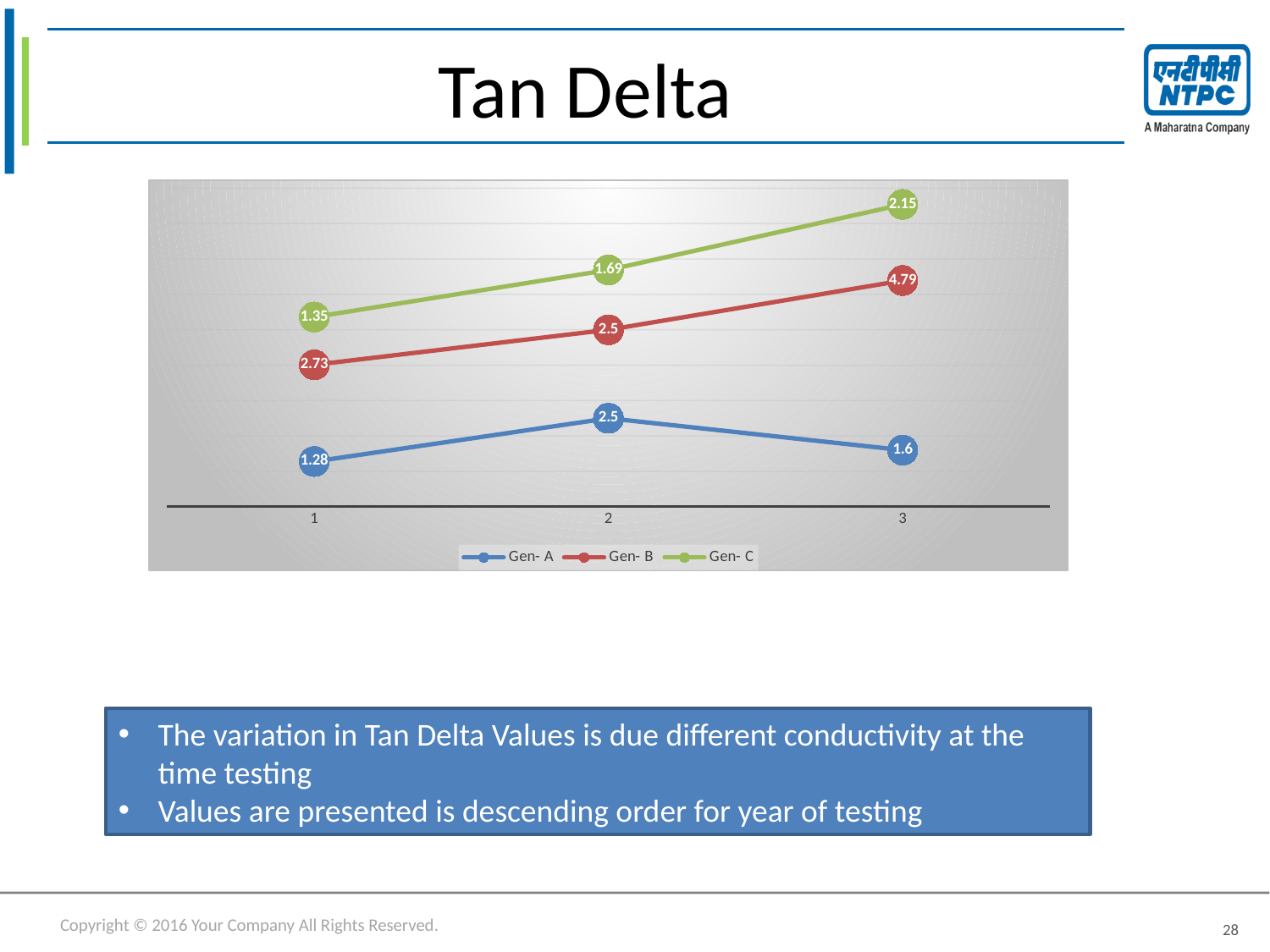
What is the value for Gen- A at x = 1? 1.28 What is the value for Gen- C at x = 2? 1.69 At which x value does Gen- A reach its highest value? 2 What is the value for Gen- C at x = 3? 2.15 What is the value for Gen- B at x = 1? 2.73 At which x value does Gen- C have its lowest value? 1 What is the value for Gen- B at x = 3? 4.79 How many series does the legend list? 3 Do the Gen- C values rise or fall from x = 1 to x = 3? Rise What kind of chart is shown on the slide? Line chart Which is larger for Gen- A: the value at x = 2 or the value at x = 3? x = 2 What is the difference between the Gen- C values at x = 3 and x = 1? 0.8